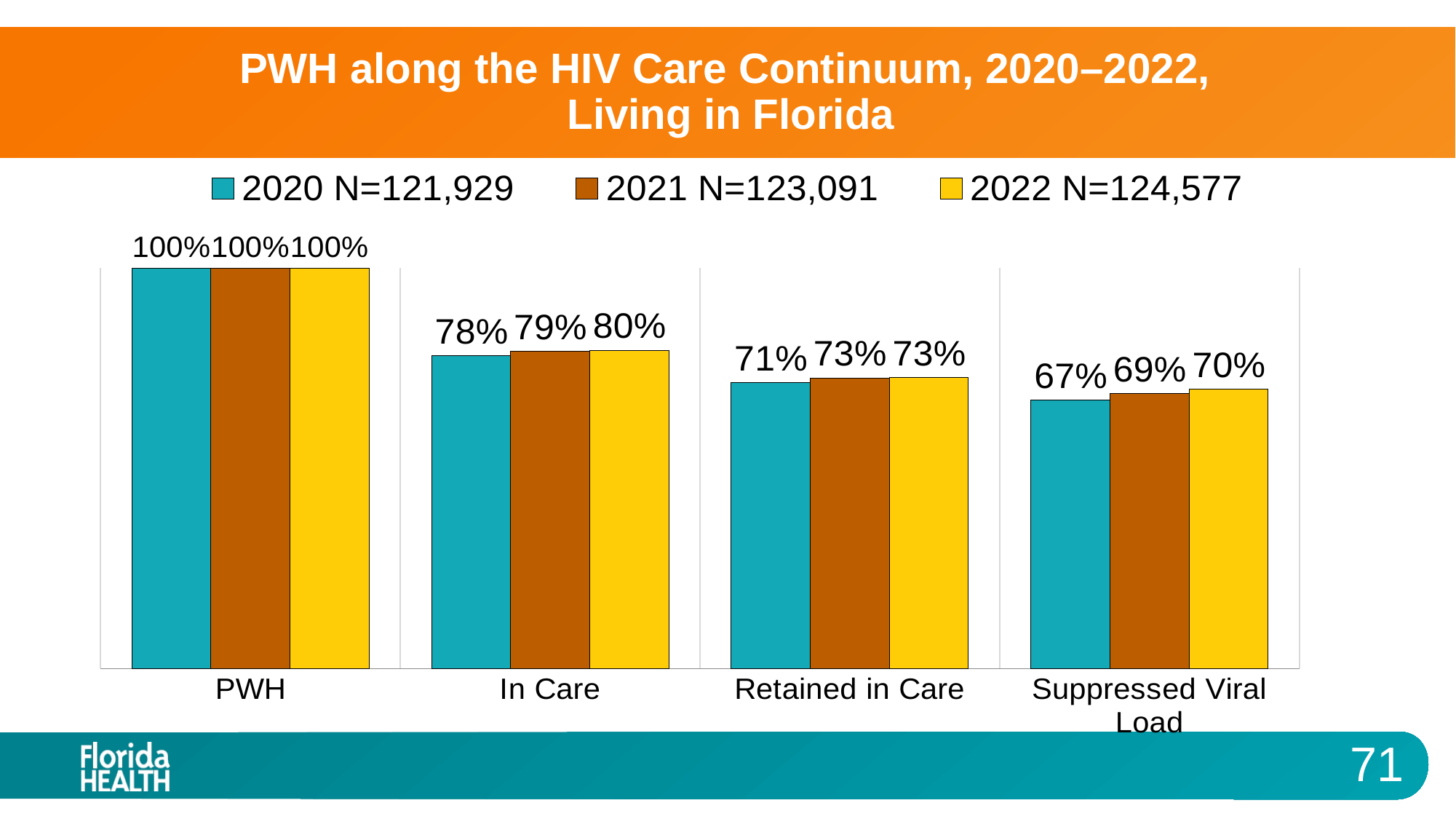
What is the value for Retained in Care in the 2021 series? 73% What kind of chart is shown on the slide? Bar chart How many categories are shown on the x axis? 4 How many series does the legend list? 3 What is the difference between the 2022 and 2020 values for Suppressed Viral Load? 3% What is the difference between the In Care and Retained in Care values in the 2021 series? 6% Which category has the lowest value in the 2020 series? Suppressed Viral Load What is the value for Suppressed Viral Load in the 2022 series? 70% Which category has the highest value in the 2022 series? PWH What is the value for In Care in the 2020 series? 78% Do the values in the 2022 series rise or fall from PWH to Suppressed Viral Load? Fall Which is larger: the 2020 value for In Care or the 2022 value for Retained in Care? 2020 value for In Care